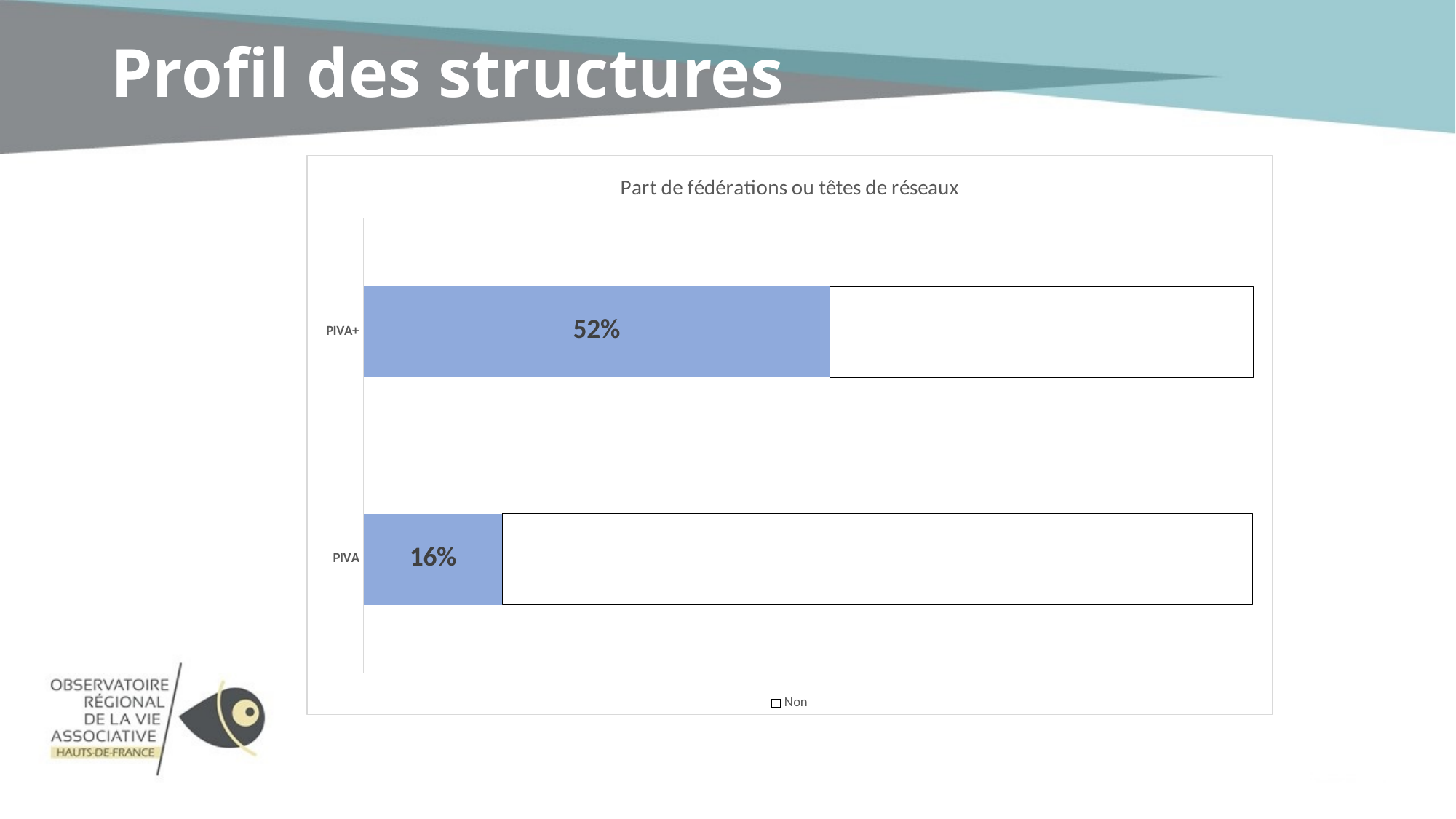
Which category has the higher labelled share of fédérations ou têtes de réseaux? PIVA+ What is the title of the chart? Part de fédérations ou têtes de réseaux Is the labelled value for PIVA+ larger or smaller than the labelled value for PIVA? larger What is the labelled value for PIVA+ in the chart? 52% Which category has the lower labelled share of fédérations ou têtes de réseaux? PIVA What is the labelled value for PIVA in the chart? 16% What entry does the chart's legend list? Non How many categories are shown on the chart's vertical axis? 2 What kind of chart is shown on the slide? bar chart What is the difference between the labelled values for PIVA+ and PIVA? 36%